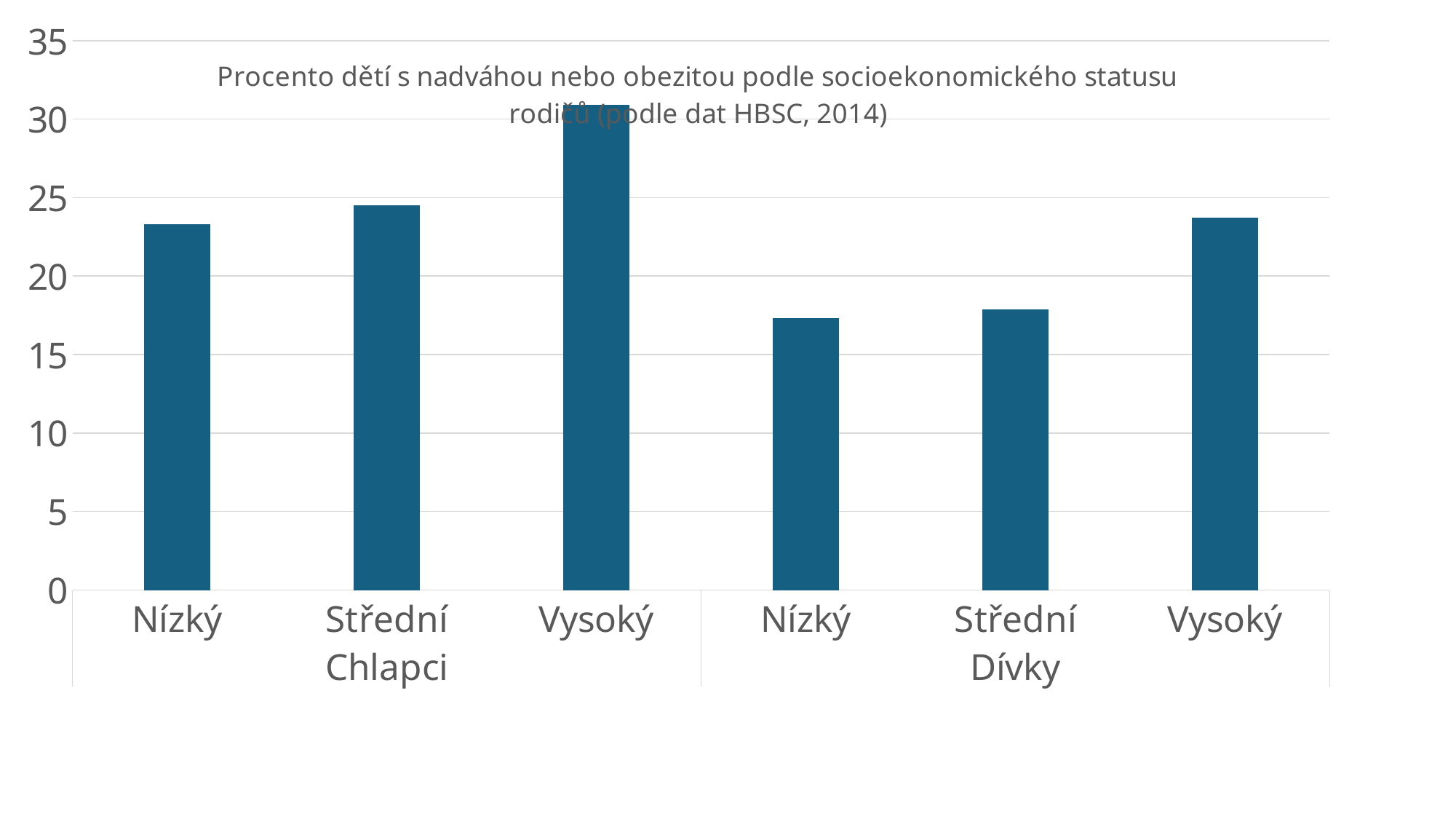
Is the value for Nízký in the Dívky group greater or less than 20? less What is the title of the chart? Procento dětí s nadváhou nebo obezitou podle socioekonomického statusu rodičů (podle dat HBSC, 2014) Is the value for Střední in the Dívky group greater or less than 15? greater How many bars are plotted in the chart? 6 Which is larger: the value for Nízký among Chlapci or the value for Nízký among Dívky? Nízký among Chlapci Which bar has the highest value in the chart? Vysoký (Chlapci) Which is larger: the value for Vysoký among Chlapci or the value for Vysoký among Dívky? Vysoký among Chlapci Within the Chlapci group, do the values rise or fall from Nízký to Vysoký? rise Is the value for Nízký in the Chlapci group greater or less than 25? less What kind of chart is shown on the slide? bar chart